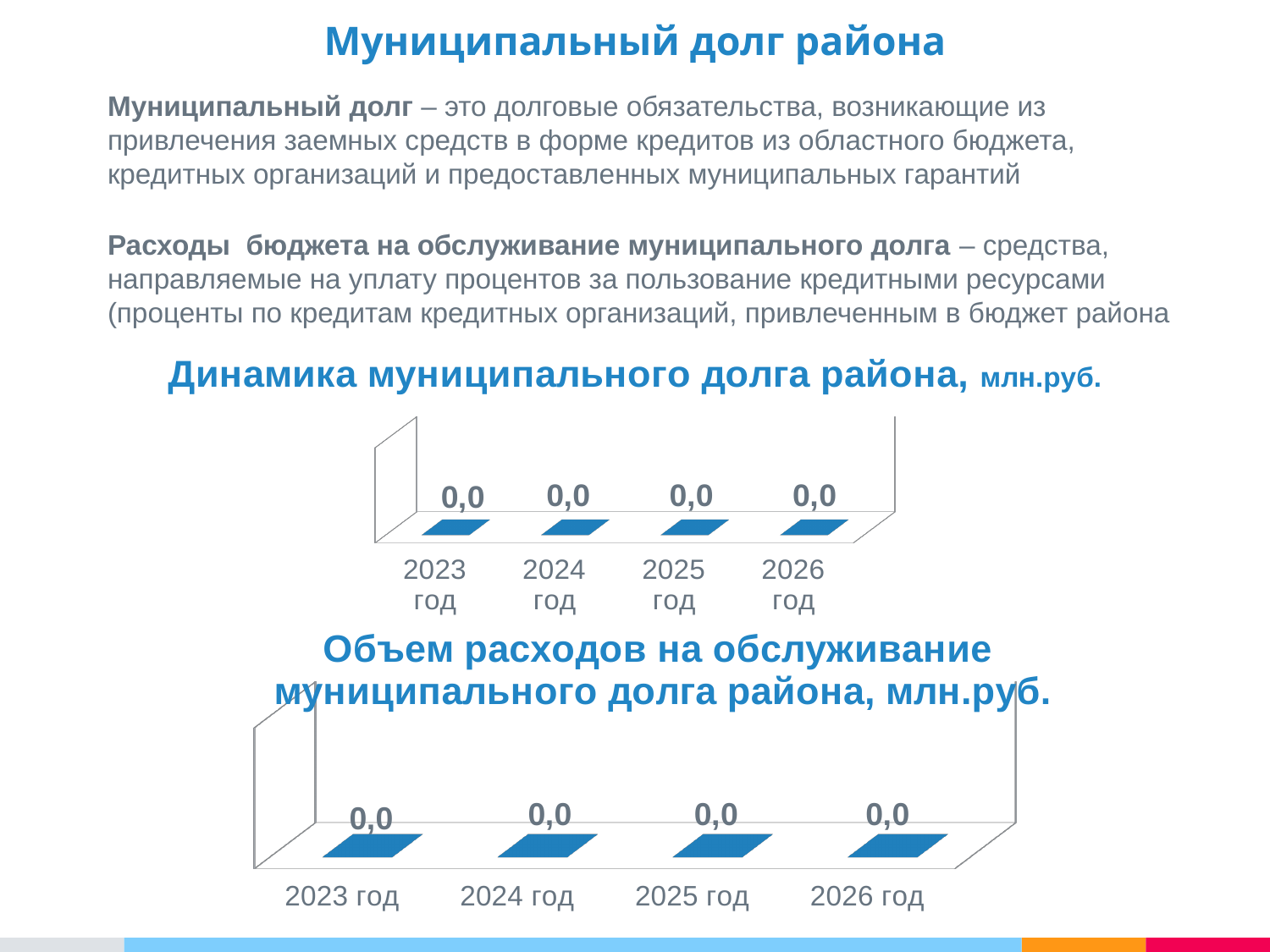
In the chart titled "Динамика муниципального долга района, млн.руб.", what is the value for 2026 год? 0,0 What unit is given in the title of the upper chart, "Динамика муниципального долга района"? млн.руб. How many categories are shown in the chart titled "Объем расходов на обслуживание муниципального долга района, млн.руб."? 4 In the chart titled "Динамика муниципального долга района, млн.руб.", what is the value for 2023 год? 0,0 What kind of chart is the upper chart, "Динамика муниципального долга района, млн.руб."? bar chart In the chart titled "Динамика муниципального долга района, млн.руб.", do the values rise, fall, or stay flat from 2023 год to 2026 год? stay flat In the chart titled "Объем расходов на обслуживание муниципального долга района, млн.руб.", what is the difference between the values for 2023 год and 2026 год? 0,0 How many categories are shown in the chart titled "Динамика муниципального долга района, млн.руб."? 4 What kind of chart is the lower chart, "Объем расходов на обслуживание муниципального долга района, млн.руб."? bar chart In the chart titled "Объем расходов на обслуживание муниципального долга района, млн.руб.", what is the value for 2025 год? 0,0 In the chart titled "Объем расходов на обслуживание муниципального долга района, млн.руб.", what is the value for 2024 год? 0,0 What colour are the bars in the lower chart, "Объем расходов на обслуживание муниципального долга района, млн.руб."? blue